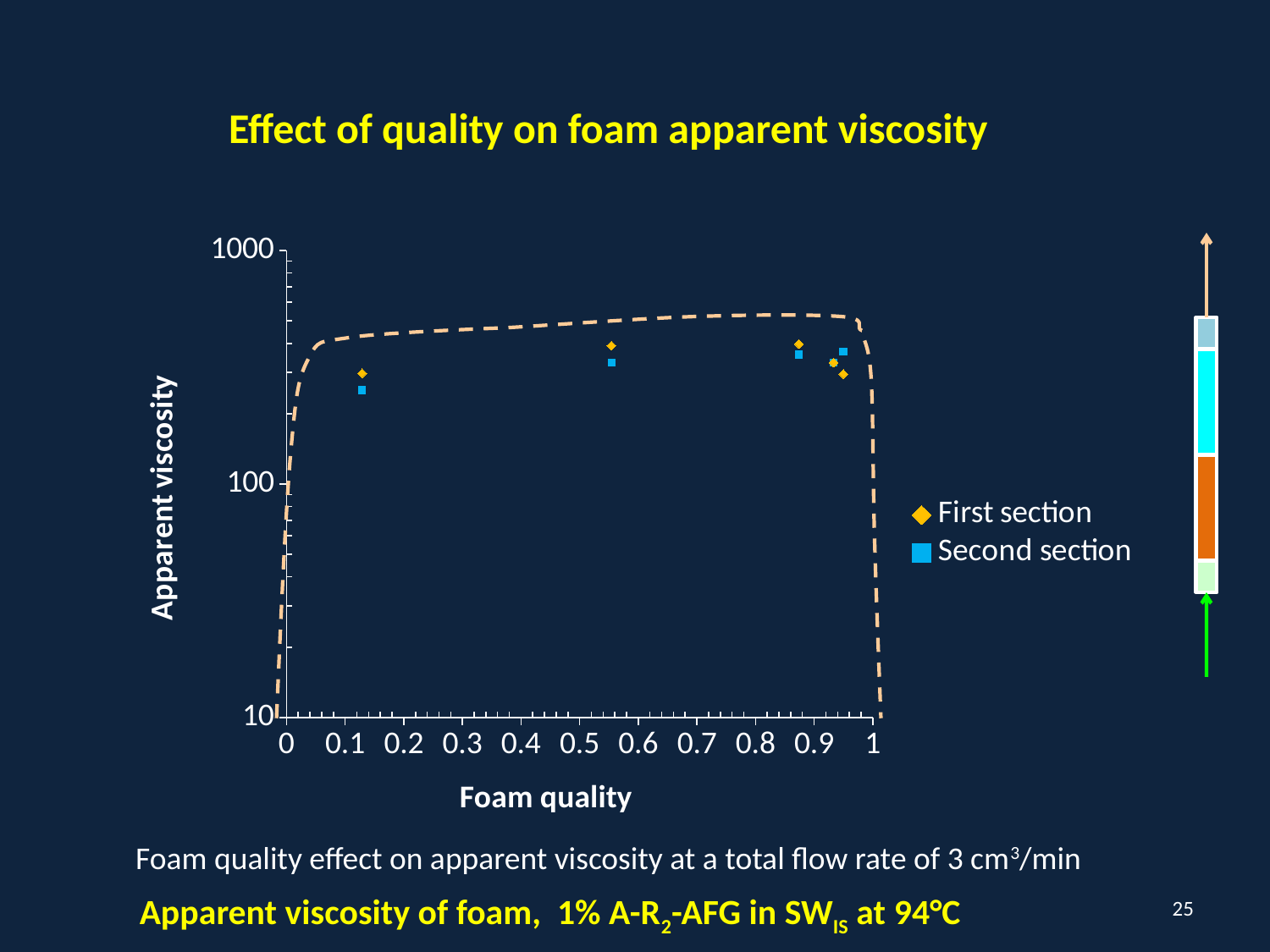
What are the two series named in the legend? First section and Second section Is the First section value at foam quality 0.9 greater or less than 1000? less Is the Second section value at foam quality 0.1 greater or less than 100? greater How many data points are plotted for the First section series? 5 What kind of chart is shown on the slide? scatter chart How many series does the legend list? 2 What is the title of the chart? Effect of quality on foam apparent viscosity At foam quality of about 0.1, which series has the higher apparent viscosity, First section or Second section? First section What is the label of the x axis? Foam quality At foam quality of about 0.55, which series has the higher apparent viscosity, First section or Second section? First section